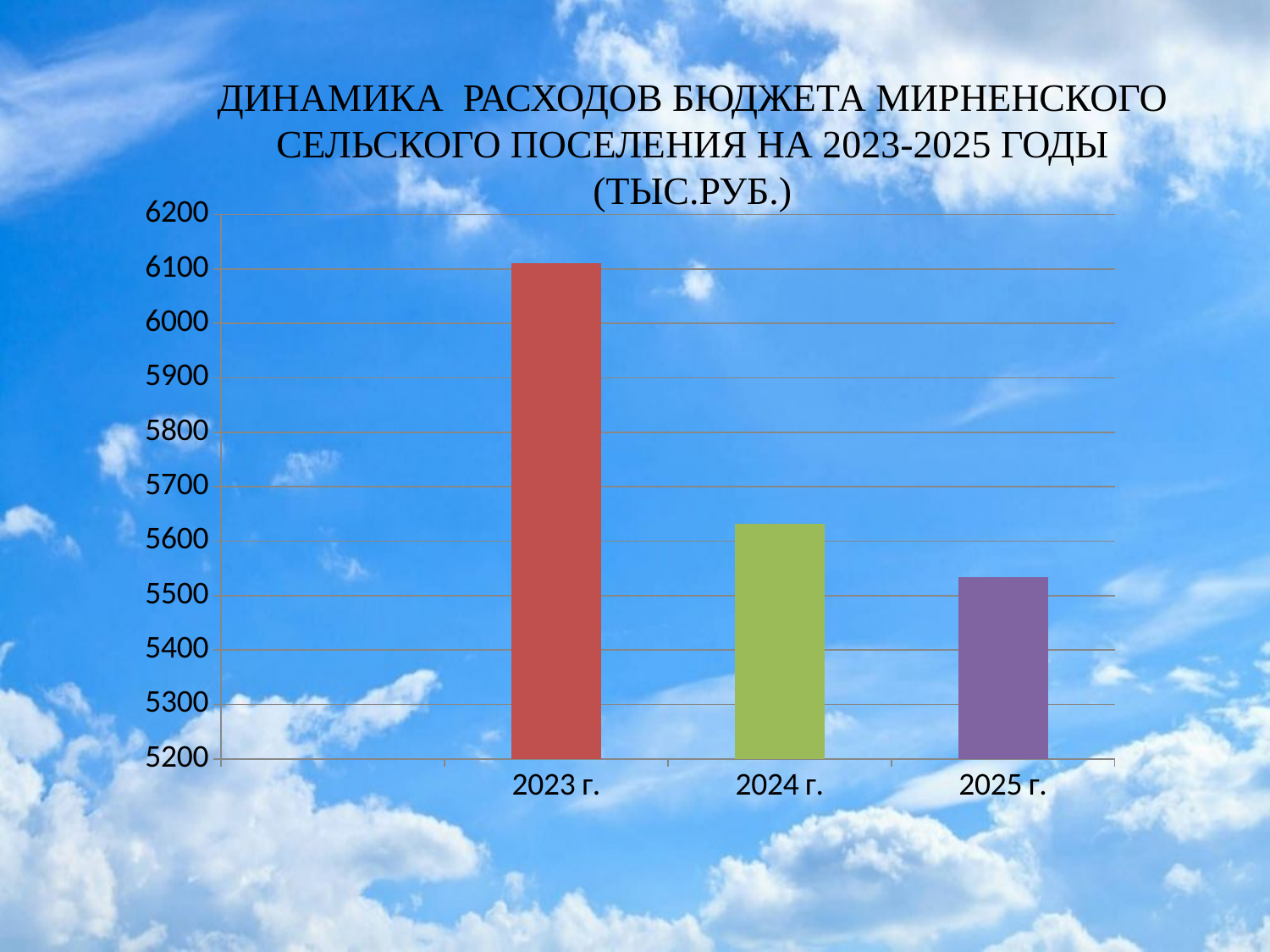
Is the value for 2024 г. greater or less than 5700? less How many years (categories) are plotted on the chart? 3 Is the value for 2024 г. greater or less than 5500? greater What kind of chart is shown on the slide? bar chart Which year has the lowest budget expenditure on the chart? 2025 г. Which is larger, the value for 2024 г. or the value for 2025 г.? 2024 г. Which year has the highest budget expenditure on the chart? 2023 г. Is the value for 2025 г. greater or less than 5600? less Which is larger, the value for 2023 г. or the value for 2024 г.? 2023 г. Do the values rise or fall from 2023 г. to 2025 г.? fall What colour is the bar for 2023 г.? red